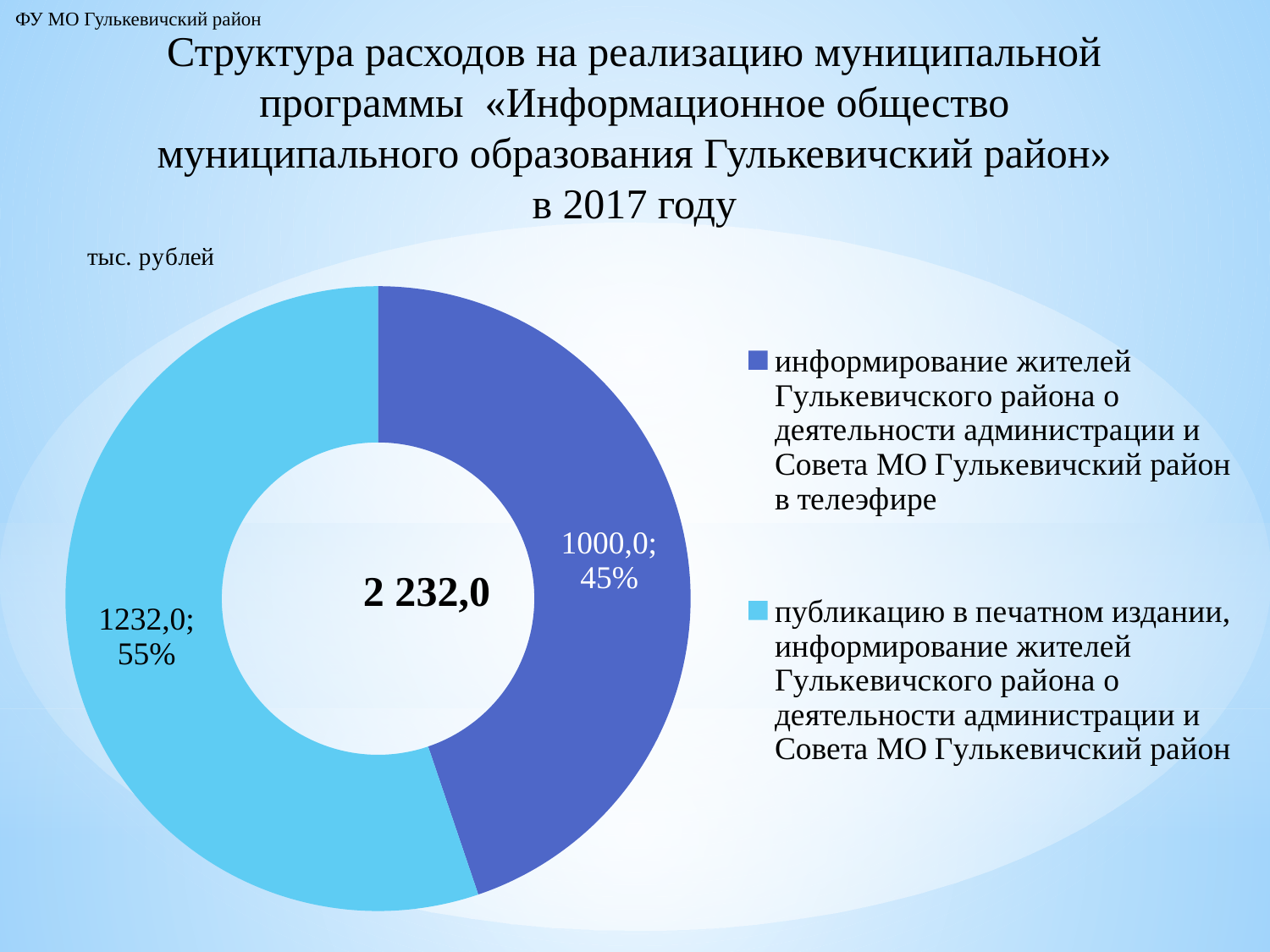
What is the difference between the value for «публикацию в печатном издании...» and the value for «информирование жителей ... в телеэфире»? 232,0 What share of the chart does the slice for «публикацию в печатном издании...» represent? 55% What share of the chart does the slice for «информирование жителей ... в телеэфире» represent? 45% How many slices does the doughnut chart have? 2 What total value is shown in the centre of the doughnut chart? 2 232,0 What is the value (тыс. рублей) for «публикацию в печатном издании, информирование жителей Гулькевичского района о деятельности администрации и Совета МО Гулькевичский район»? 1232,0 What is the value (тыс. рублей) for «информирование жителей Гулькевичского района о деятельности администрации и Совета МО Гулькевичский район в телеэфире»? 1000,0 What unit of measurement is indicated for the chart? тыс. рублей Which category has the smallest slice? информирование жителей Гулькевичского района о деятельности администрации и Совета МО Гулькевичский район в телеэфире Which category has the largest slice? публикацию в печатном издании, информирование жителей Гулькевичского района о деятельности администрации и Совета МО Гулькевичский район What kind of chart is shown on the slide? Doughnut (pie) chart How many entries does the legend list? 2